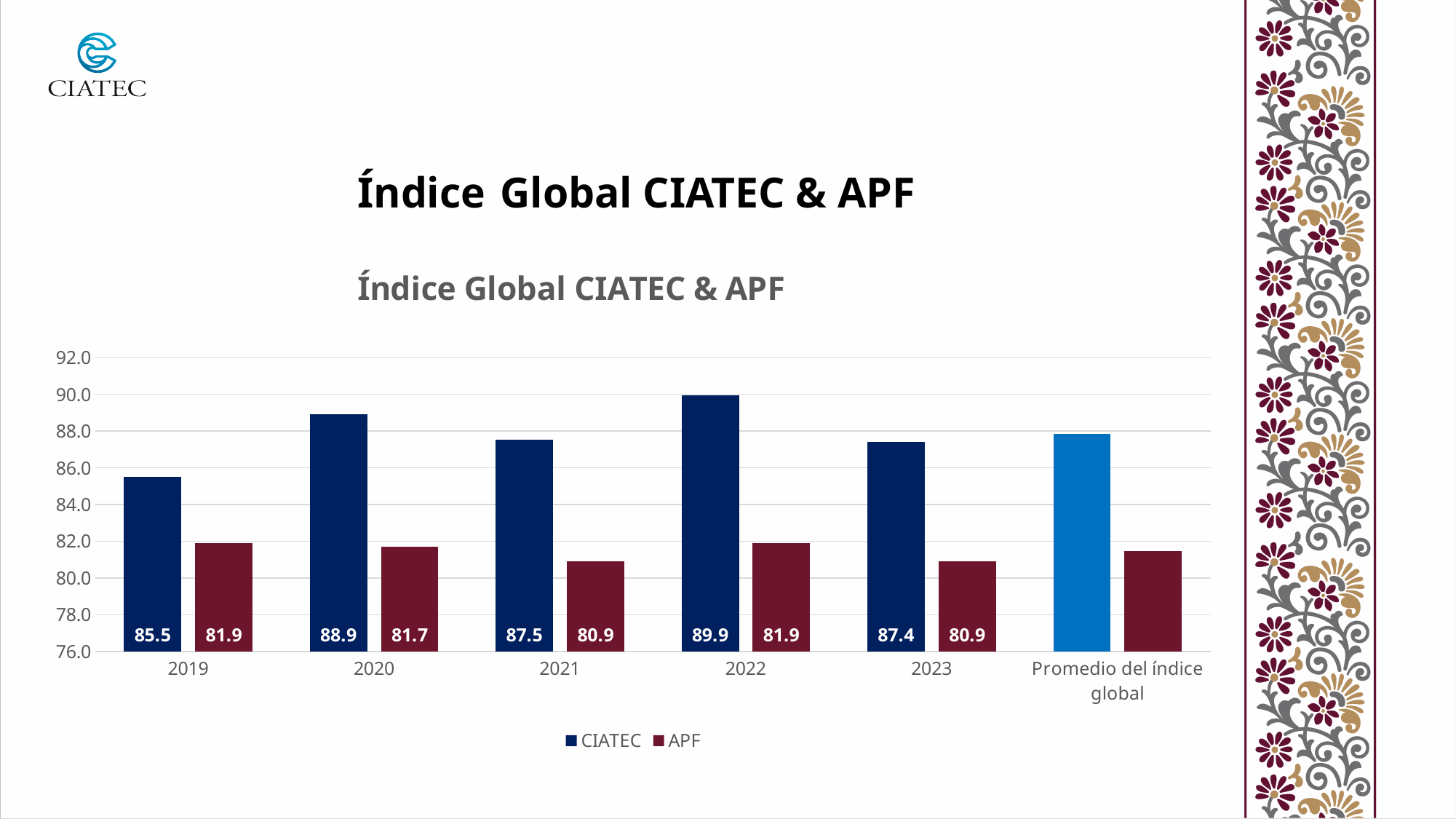
What is the CIATEC value for 2022? 89.9 What kind of chart is shown on the slide? bar chart How many categories are shown on the x axis? 6 What is the APF value for 2021? 80.9 What is the APF value for 2020? 81.7 What is the difference between the CIATEC and APF values in 2022? 8.0 In which year is the CIATEC value highest? 2022 Is the CIATEC value for "Promedio del índice global" greater or less than 86.0? greater In which year is the CIATEC value lowest? 2019 How many series does the legend list? 2 Which is larger, the CIATEC value for 2020 or for 2021? 2020 What is the CIATEC value for 2019? 85.5